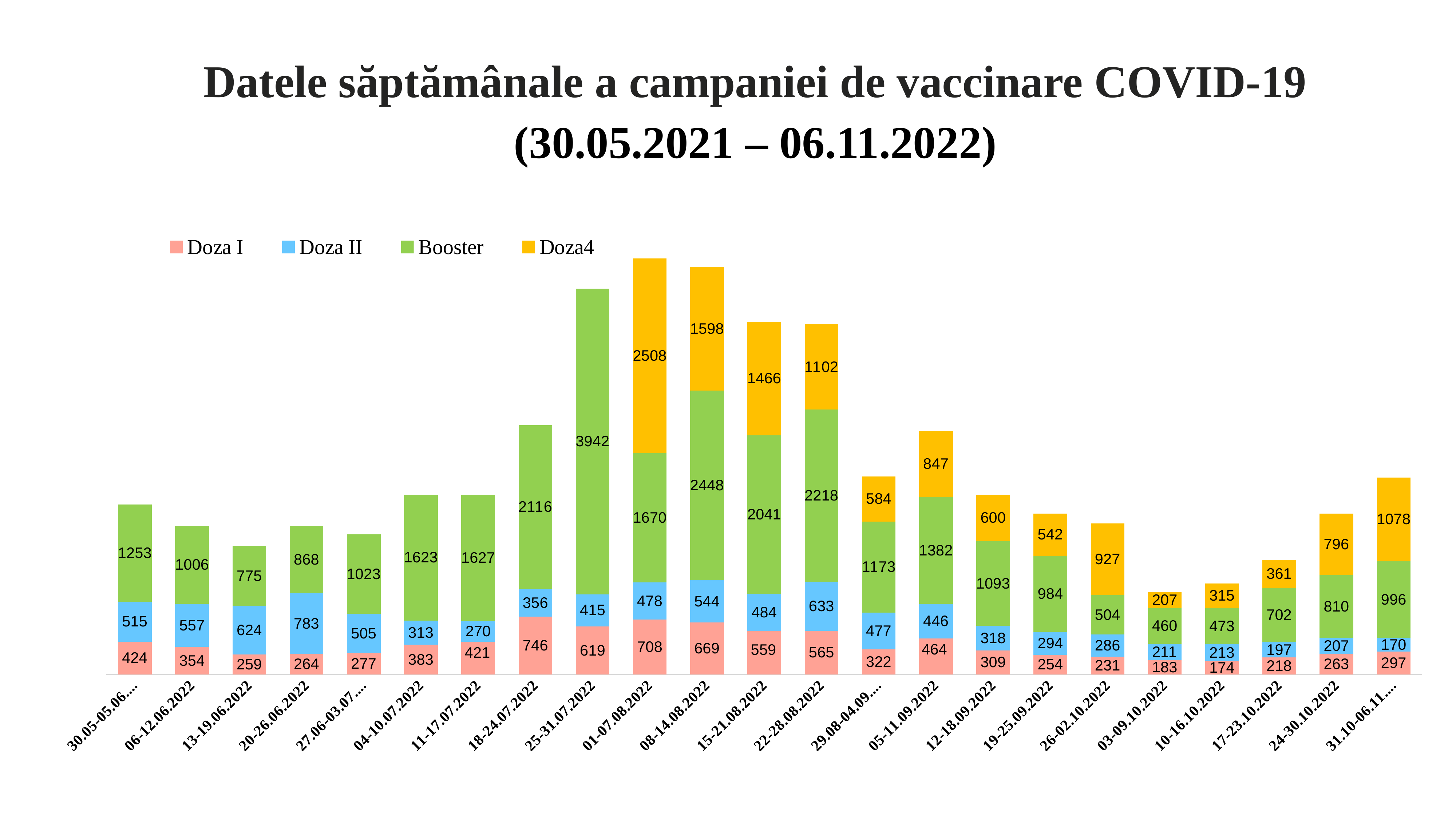
What is the Doza I value for the week 18-24.07.2022? 746 What is the Booster value for the week 25-31.07.2022? 3942 How many series does the legend list? 4 What is the difference between the Doza4 values for 01-07.08.2022 and 08-14.08.2022? 910 Which week has the highest Booster value? 25-31.07.2022 Which series is shown in yellow in the legend? Doza4 Which is larger for the week 24-30.10.2022: the Booster value or the Doza4 value? Booster How many weeks (categories) are shown on the x axis? 23 Which week has the lowest Doza II value? 31.10-06.11.... What is the total of the stacked bar for the week 12-18.09.2022? 2320 What is the Doza4 value for the week 01-07.08.2022? 2508 What kind of chart is shown on the slide? Stacked bar chart